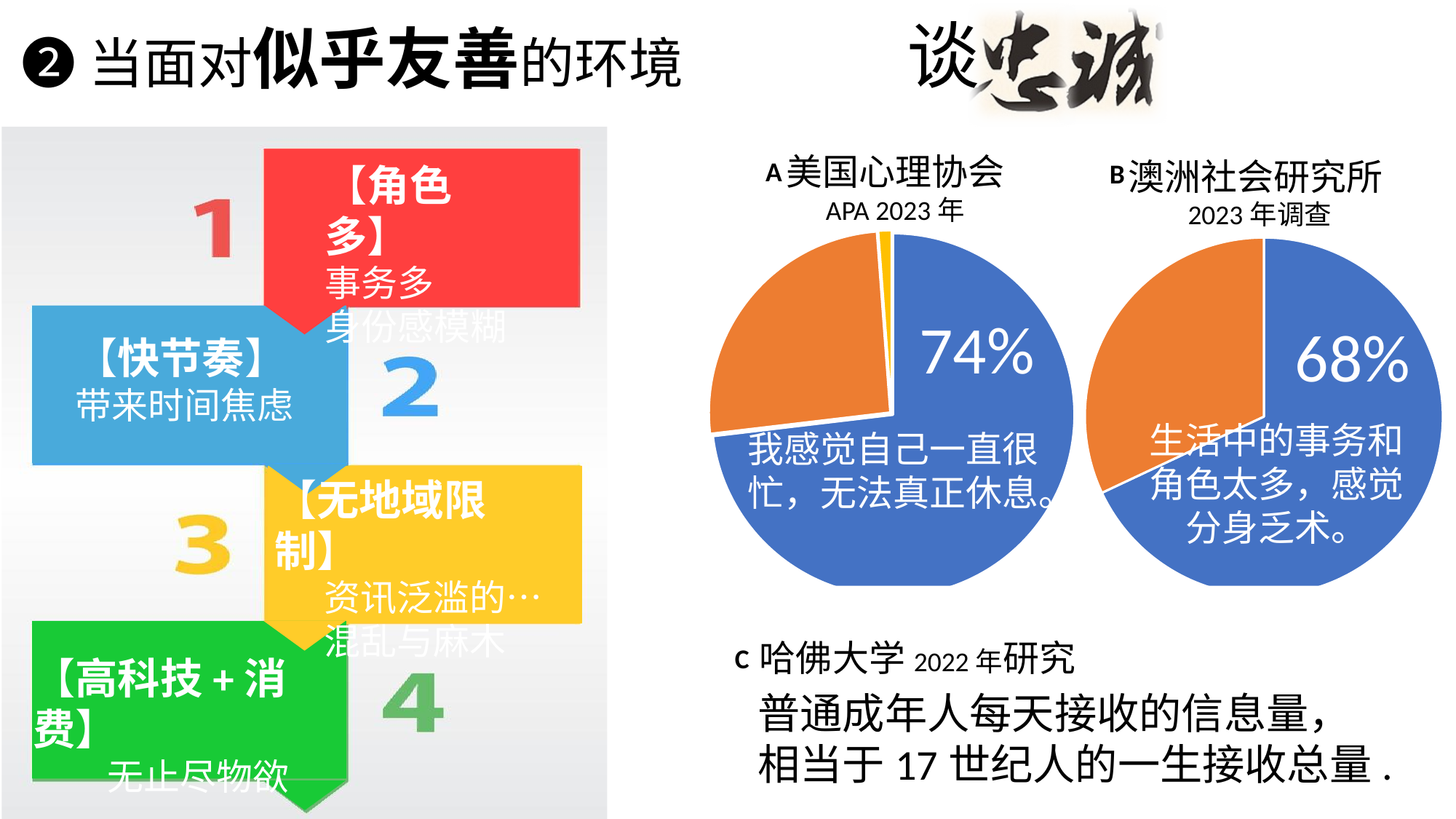
In the chart titled B 澳洲社会研究所 2023 年调查, what share of the pie does the blue slice represent? 68% In the chart titled A 美国心理协会 APA 2023 年, what share of the pie does the blue slice represent? 74% In the chart titled B 澳洲社会研究所 2023 年调查, which slice is the largest? the blue slice In the chart titled A 美国心理协会 APA 2023 年, which slice is the smallest? the yellow slice How many slices does the pie chart titled B 澳洲社会研究所 2023 年调查 have? 2 What kind of chart is the chart titled B 澳洲社会研究所 2023 年调查? pie chart What kind of chart is the chart titled A 美国心理协会 APA 2023 年? pie chart In the chart titled A 美国心理协会 APA 2023 年, what percentage is printed on the largest slice? 74% How many slices does the pie chart titled A 美国心理协会 APA 2023 年 have? 3 Which pie chart shows the larger labeled percentage, A 美国心理协会 APA 2023 年 or B 澳洲社会研究所 2023 年调查? A 美国心理协会 APA 2023 年 In the chart titled B 澳洲社会研究所 2023 年调查, what percentage is printed on the largest slice? 68% What colour is the slice labeled 74% in the chart titled A 美国心理协会 APA 2023 年? blue